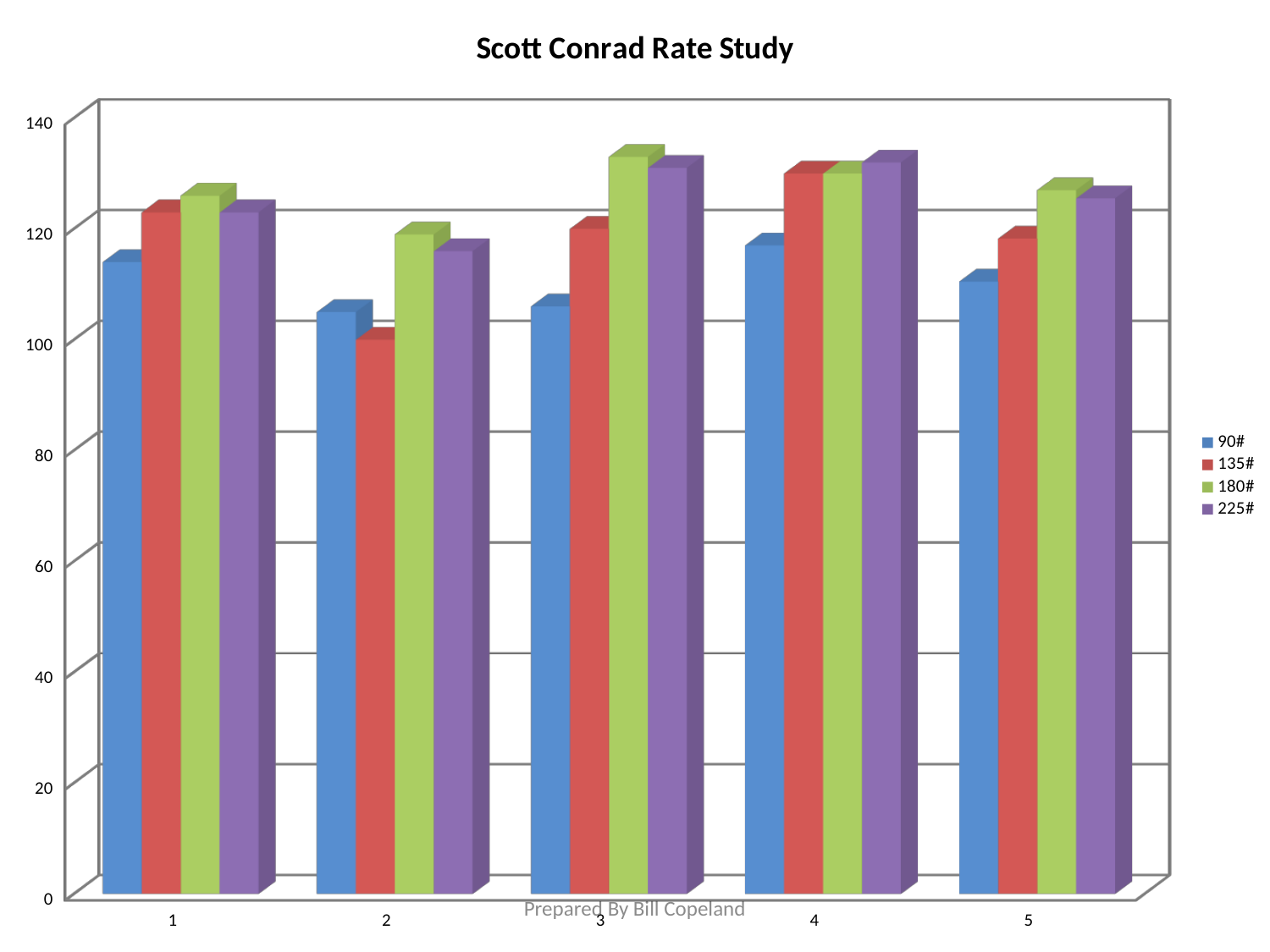
What kind of chart is shown on the slide? bar chart For the 135# series, which category has the lowest value? 2 What is the title of the chart? Scott Conrad Rate Study For the 135# series, which category has the highest value? 4 Is the value for 225# at category 4 greater or less than 120? greater At category 3, which is larger: the 90# value or the 180# value? 180# At category 2, which is larger: the 135# value or the 180# value? 180# Which series are listed in the legend? 90#, 135#, 180#, 225# Is the value for 90# at category 2 greater or less than 120? less How many categories are shown on the x axis? 5 How many series does the legend list? 4 Is the value for 180# at category 3 greater or less than 120? greater